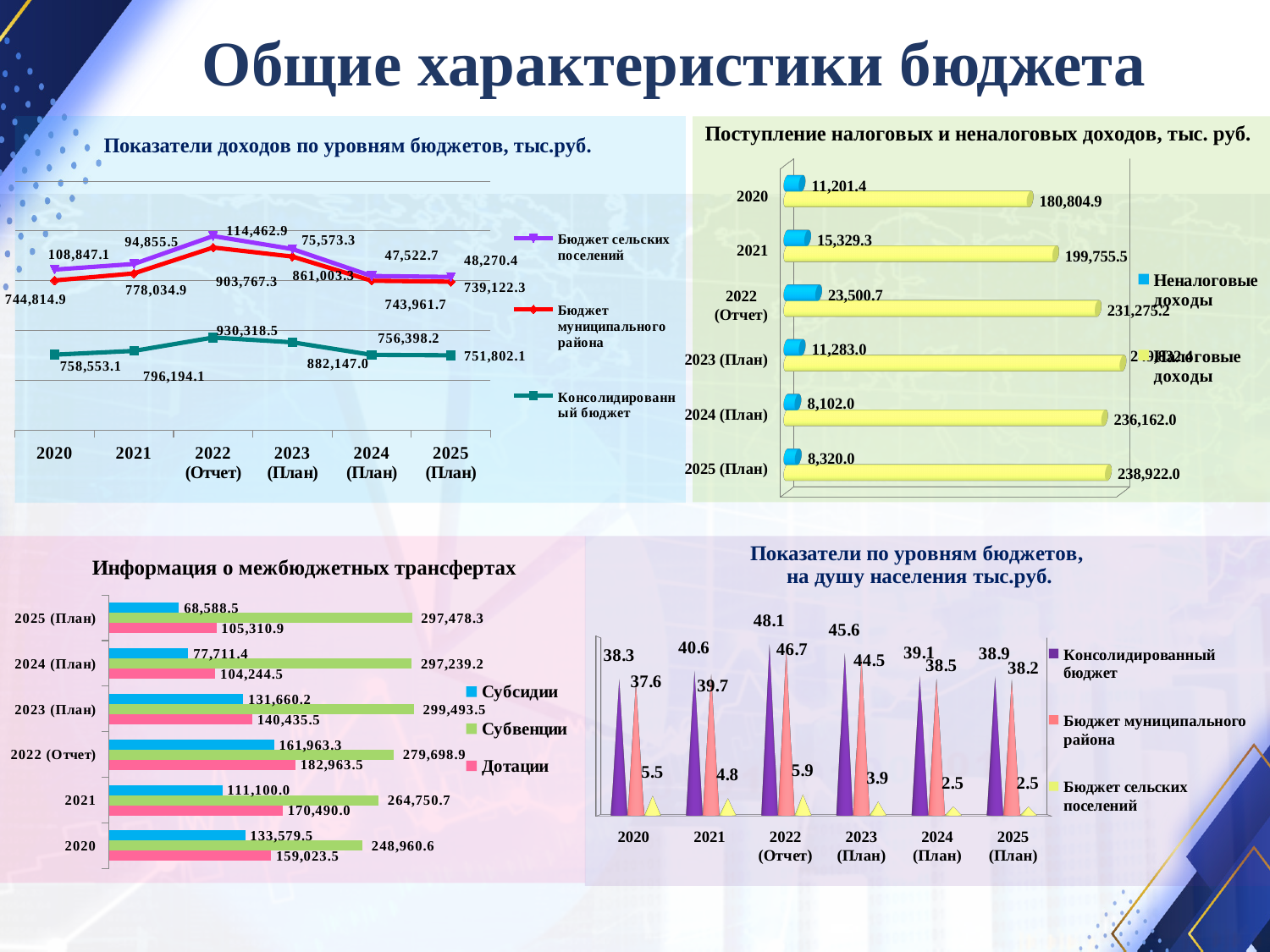
In the chart 'Поступление налоговых и неналоговых доходов, тыс. руб.', what is the value of Налоговые доходы for 2025 (План)? 238,922.0 In the chart 'Показатели по уровням бюджетов, на душу населения тыс.руб.', what is the value of Консолидированный бюджет for 2022 (Отчет)? 48.1 In the chart 'Показатели по уровням бюджетов, на душу населения тыс.руб.', which is larger for 2021: Бюджет муниципального района or Бюджет сельских поселений? Бюджет муниципального района In the chart 'Информация о межбюджетных трансфертах', what is the difference between Дотации and Субсидии for 2020? 25,444.0 In the chart 'Показатели доходов по уровням бюджетов, тыс.руб.', which year has the lowest value for Бюджет сельских поселений? 2024 (План) In the chart 'Информация о межбюджетных трансфертах', what is the value of Субвенции for 2023 (План)? 299,493.5 In the chart 'Показатели доходов по уровням бюджетов, тыс.руб.', what is the value of Консолидированный бюджет for 2022 (Отчет)? 930,318.5 In the chart 'Поступление налоговых и неналоговых доходов, тыс. руб.', which year has the highest value of Неналоговые доходы? 2022 (Отчет) In the chart 'Информация о межбюджетных трансфертах', how many year categories are shown? 6 In the chart 'Показатели доходов по уровням бюджетов, тыс.руб.', what type of chart is used? Line chart In the chart 'Поступление налоговых и неналоговых доходов, тыс. руб.', how many series does the legend list? 2 In the chart 'Показатели по уровням бюджетов, на душу населения тыс.руб.', does the value for Бюджет сельских поселений rise or fall from 2022 (Отчет) to 2024 (План)? Fall